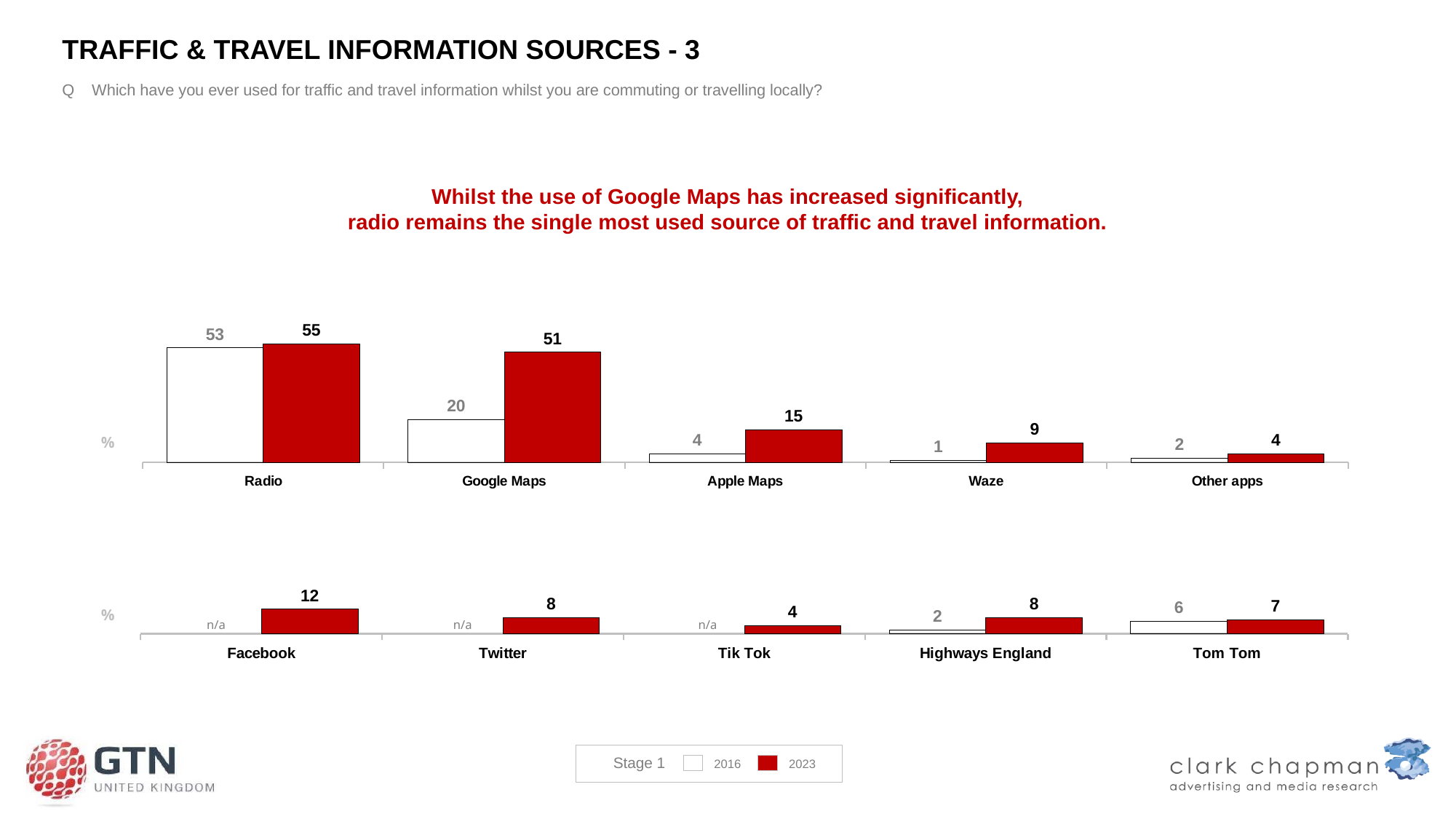
In the top chart, which category has the highest 2023 value? Radio In the bottom chart, which is larger: the 2023 value for Twitter or the 2023 value for Tik Tok? Twitter How many series does the legend list? 2 In the top chart, what is the 2016 value for Google Maps? 20 In the top chart, what is the 2023 value for Radio? 55 In the bottom chart, which categories show n/a for 2016? Facebook, Twitter, Tik Tok How many categories are shown in the bottom chart? 5 In the bottom chart, what is the 2023 value for Facebook? 12 In the top chart, what is the difference between the 2023 and 2016 values for Google Maps? 31 In the bottom chart, what is the 2016 value for Tom Tom? 6 In the top chart, which category has the lowest 2016 value? Waze What type of chart is the top chart? Bar chart